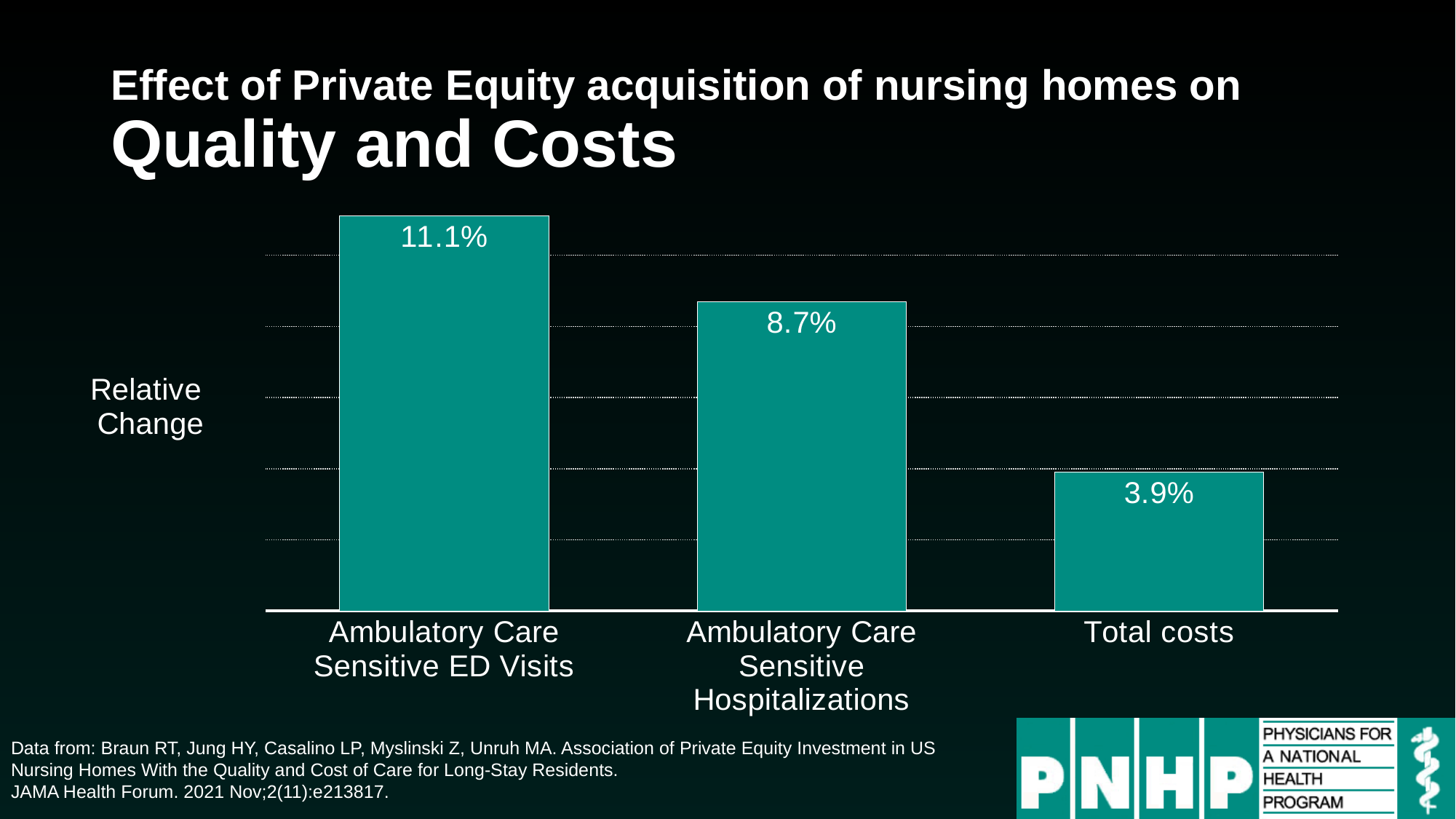
Which is larger, the relative change for Ambulatory Care Sensitive Hospitalizations or for Total costs? Ambulatory Care Sensitive Hospitalizations What is the relative change for Ambulatory Care Sensitive ED Visits? 11.1% What is the difference between the relative change for Ambulatory Care Sensitive ED Visits and Total costs? 7.2% Which category has the lowest relative change? Total costs What is the relative change for Total costs? 3.9% Do the values rise or fall from left to right across the categories? Fall What is the relative change for Ambulatory Care Sensitive Hospitalizations? 8.7% What is the label on the vertical axis of the chart? Relative Change How many categories are shown in the chart? 3 What is the difference between the relative change for Ambulatory Care Sensitive ED Visits and Ambulatory Care Sensitive Hospitalizations? 2.4% What kind of chart is shown on the slide? Bar chart Which category has the highest relative change? Ambulatory Care Sensitive ED Visits